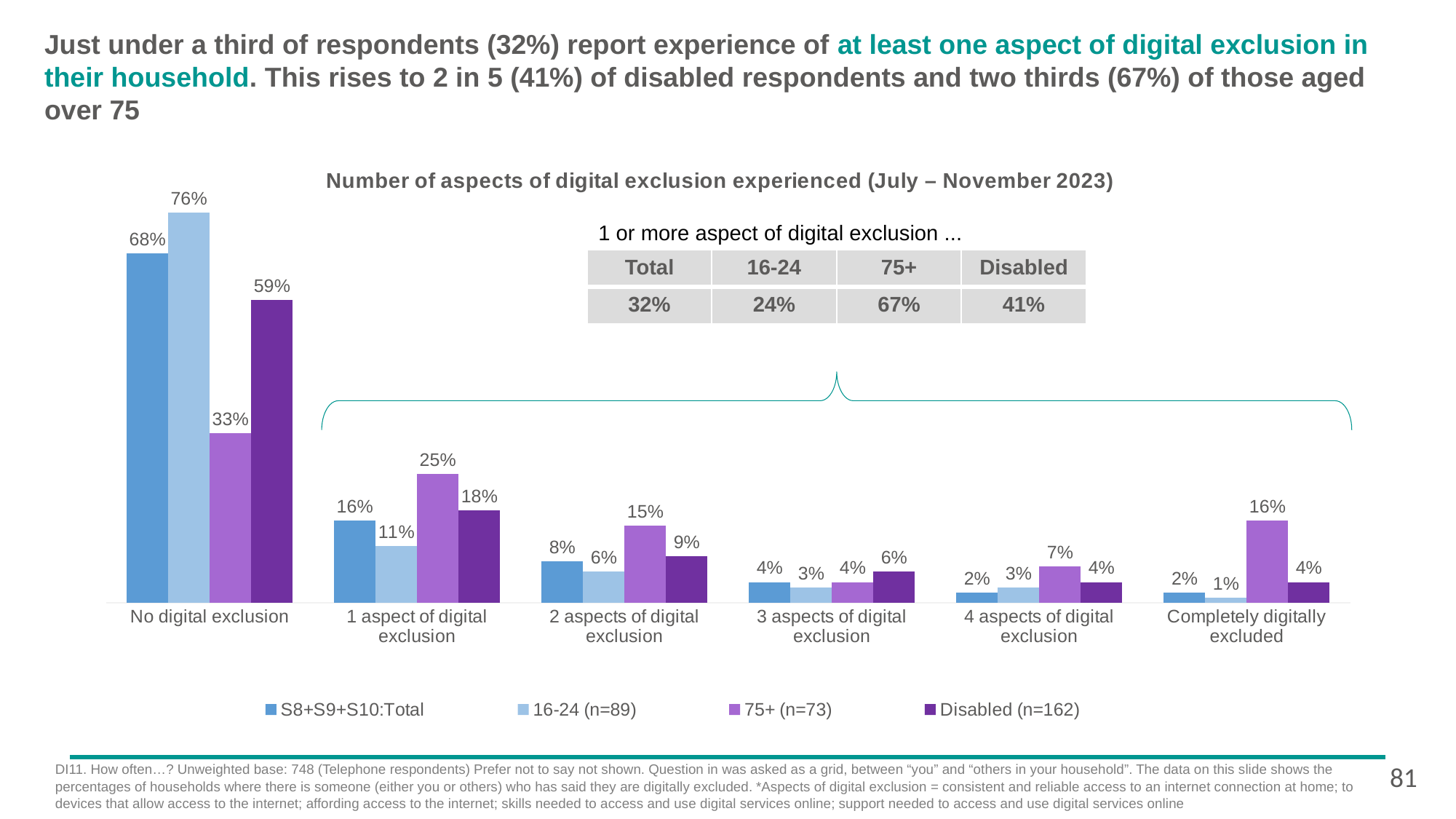
What is the value for Disabled (n=162) in the 'Completely digitally excluded' category? 4% According to the table, what percentage of 75+ respondents report 1 or more aspect of digital exclusion? 67% What kind of chart is shown on the slide? Bar chart Which series has the highest value in the '2 aspects of digital exclusion' category? 75+ (n=73) What is the value for 16-24 (n=89) in the 'No digital exclusion' category? 76% What is the title of the chart? Number of aspects of digital exclusion experienced (July – November 2023) Which series has the lowest value in the 'No digital exclusion' category? 75+ (n=73) How many series does the legend list? 4 How many categories are shown on the x axis of the chart? 6 What is the value for 75+ (n=73) in the '1 aspect of digital exclusion' category? 25% What is the difference between the S8+S9+S10:Total and 75+ (n=73) values in the 'No digital exclusion' category? 35 percentage points In the '1 aspect of digital exclusion' category, which is larger: the value for S8+S9+S10:Total or for 16-24 (n=89)? S8+S9+S10:Total